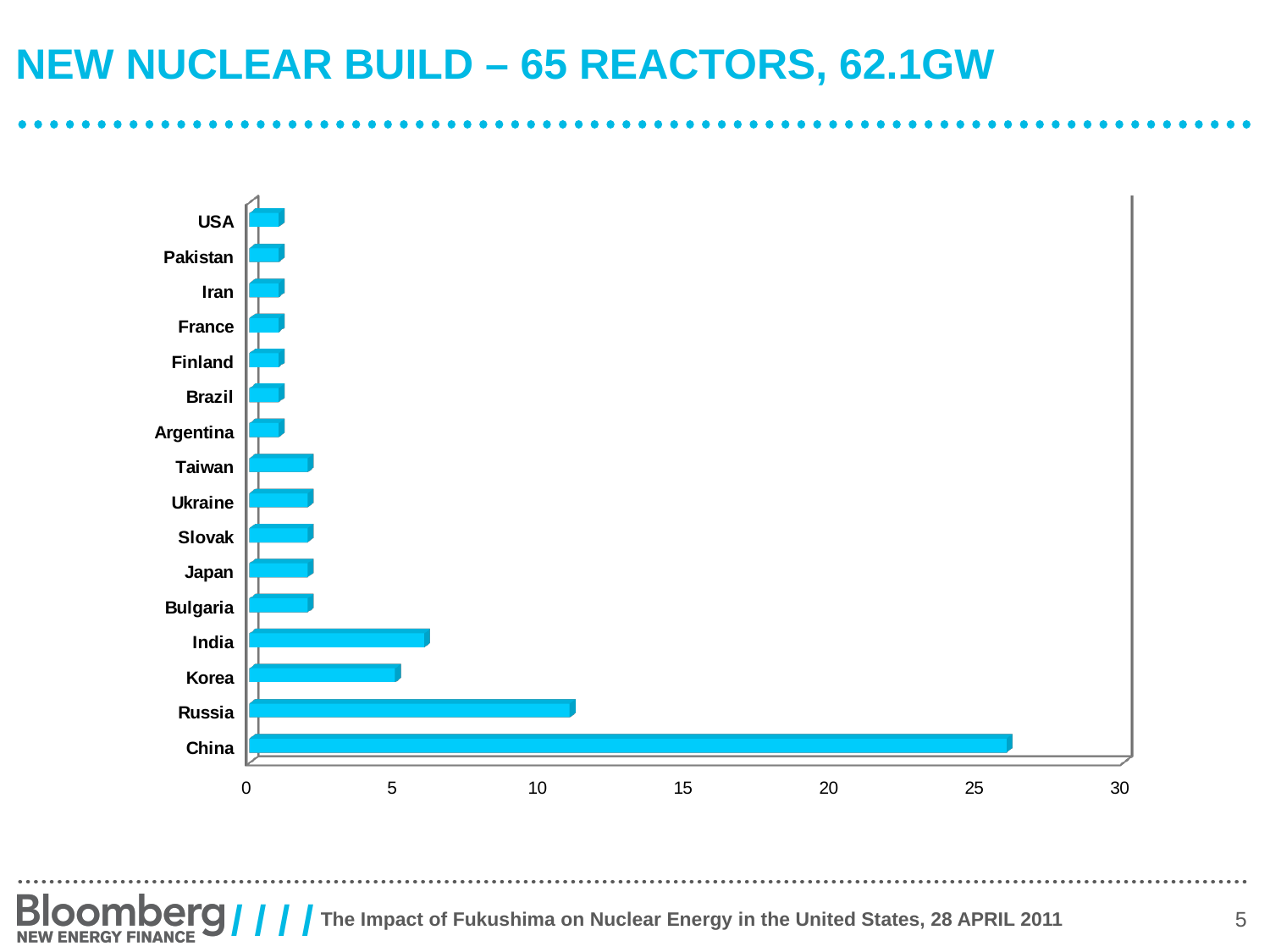
Is the value for China greater or less than 25? greater Which has a larger value, China or Russia? China Is the value for India greater or less than 5? greater Which has a larger value, Russia or India? Russia Which country has the highest value on the chart? China What kind of chart is shown on the slide? bar chart How many countries are listed on the chart? 16 What is the title of the slide containing the chart? NEW NUCLEAR BUILD – 65 REACTORS, 62.1GW Is the value for Russia greater or less than 10? greater Which has a larger value, Taiwan or USA? Taiwan